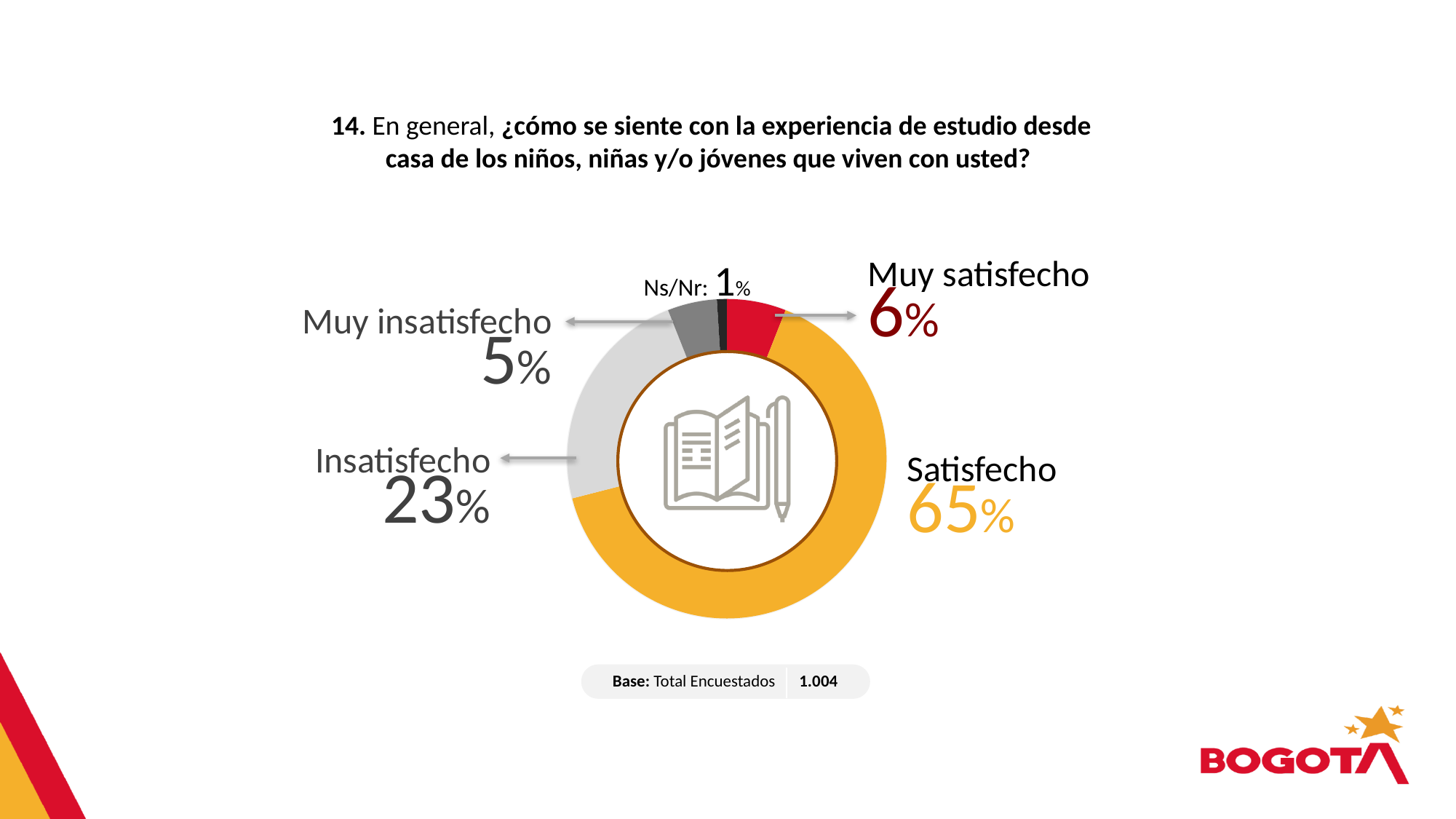
Which response category has the largest share? Satisfecho What is the difference in percentage points between "Satisfecho" and "Insatisfecho"? 42 What percentage of respondents answered "Satisfecho"? 65% How many response categories are shown in the chart? 5 What percentage of respondents answered "Insatisfecho"? 23% What percentage of respondents answered "Muy satisfecho"? 6% What is the base (total respondents) shown below the chart? 1.004 Which response category has the smallest share? Ns/Nr Which is larger, the share for "Muy satisfecho" or for "Muy insatisfecho"? Muy satisfecho What kind of chart is shown on the slide? Doughnut (pie) chart What percentage of respondents answered "Muy insatisfecho"? 5% What percentage of respondents answered "Ns/Nr"? 1%